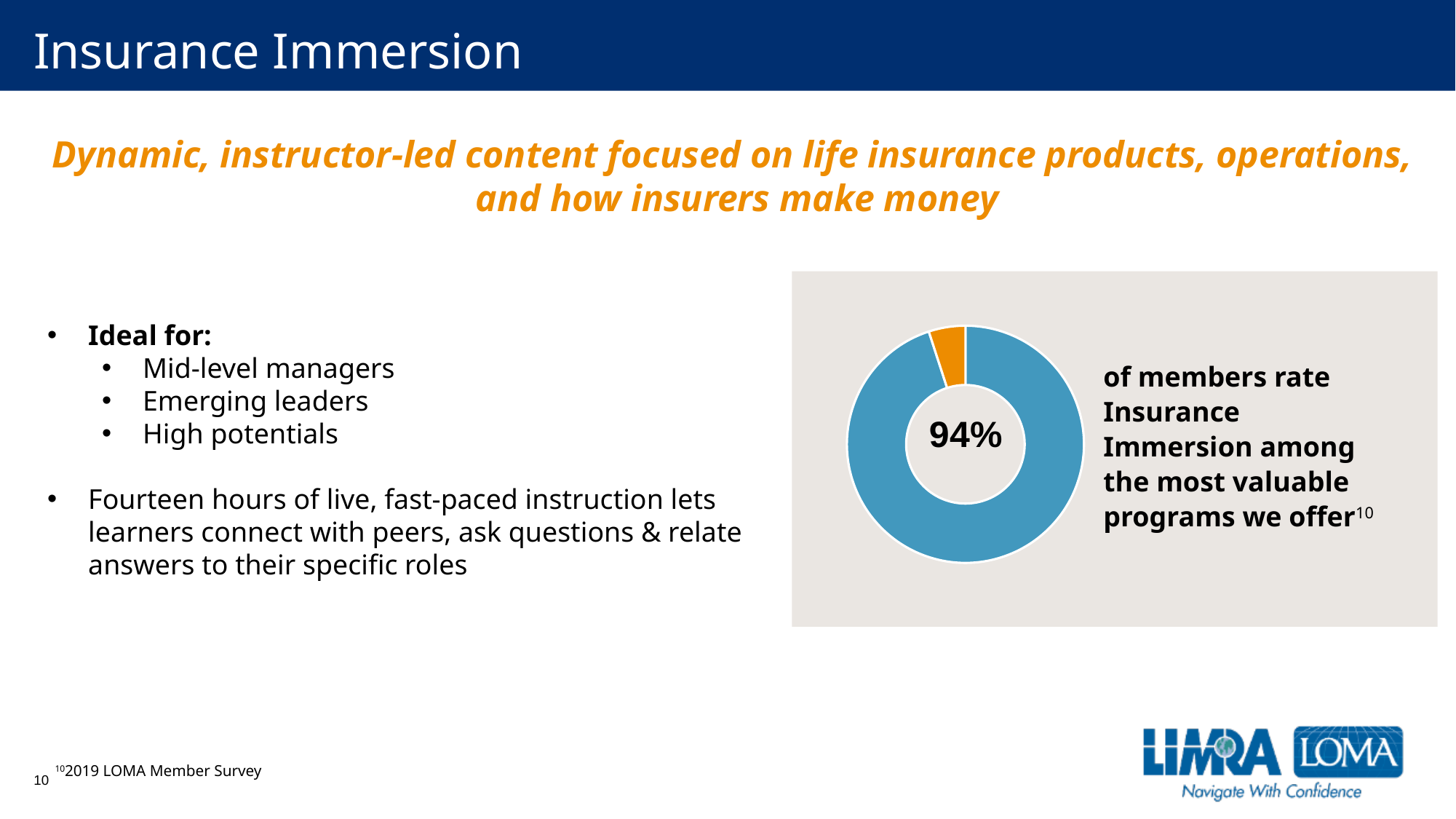
According to the footnote, what is the source of the 94% figure in the donut chart? 2019 LOMA Member Survey Which slice of the donut chart is larger, the blue one or the orange one? The blue one How many slices does the donut chart have? 2 What percentage is printed in the centre of the donut chart? 94% What kind of chart is shown on the slide? Donut (pie) chart Is the blue slice of the donut chart greater or less than 50% of the whole? greater What share of members rate Insurance Immersion among the most valuable programs offered? 94% What colour is the smaller slice of the donut chart? Orange